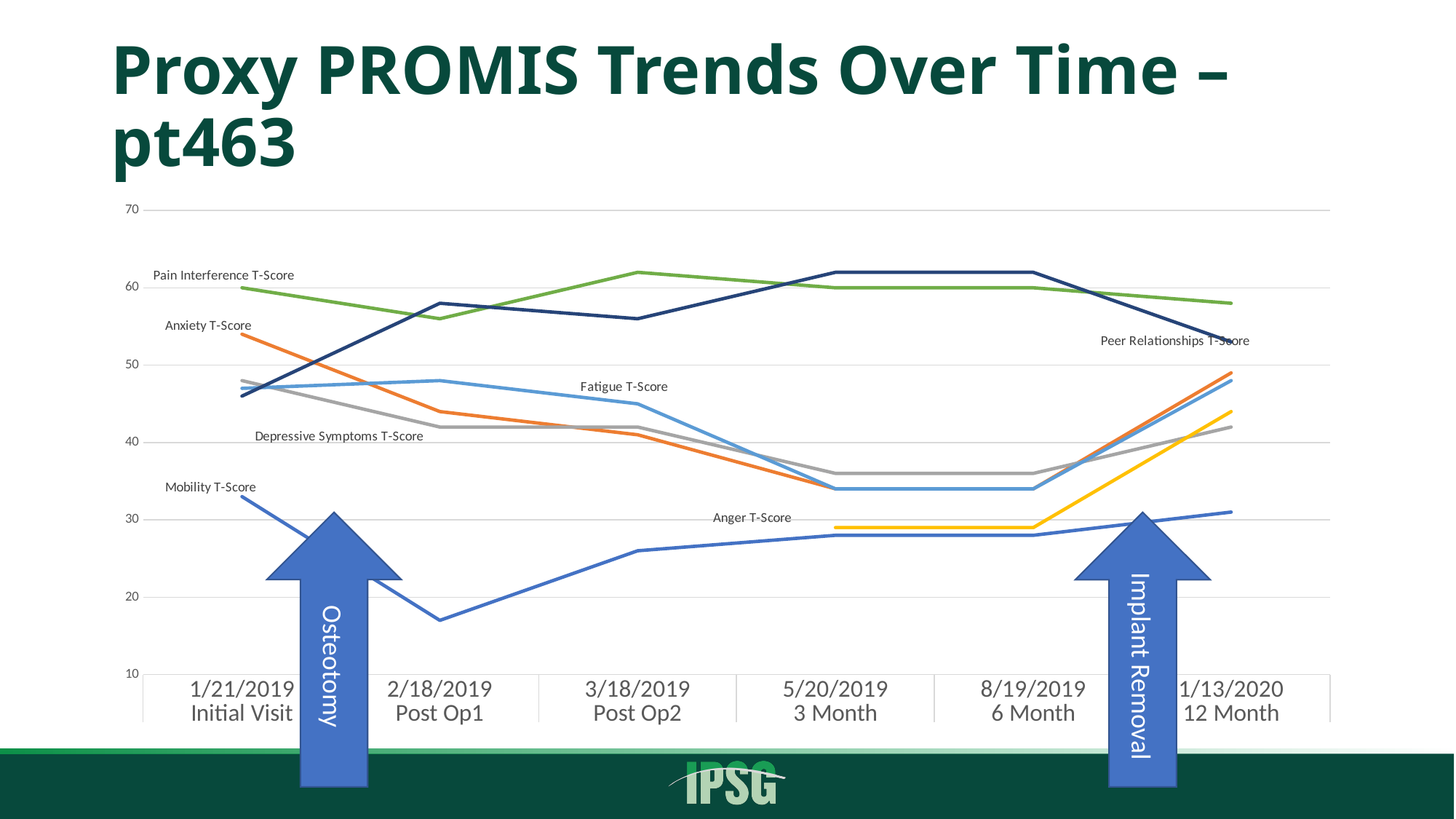
Is the Anger T-Score at 1/13/2020 12 Month greater or less than 40? greater Is the Mobility T-Score at 2/18/2019 Post Op1 greater or less than 20? less How many T-Score series are labelled on the chart? 7 How many time points are shown on the x axis of the chart? 6 At 1/13/2020 12 Month, which is higher: the Pain Interference T-Score or the Peer Relationships T-Score? Pain Interference T-Score What type of chart is shown on the slide? line chart Does the Anxiety T-Score rise or fall from the Initial Visit to the 3 Month visit? fall Is the Anxiety T-Score at the 1/21/2019 Initial Visit greater or less than 50? greater What is the Pain Interference T-Score at the 1/21/2019 Initial Visit? 60 What event does the arrow on the right side of the chart mark? Implant Removal Which series has the highest value at 3/18/2019 Post Op2? Pain Interference T-Score Which series has the lowest value at 2/18/2019 Post Op1? Mobility T-Score